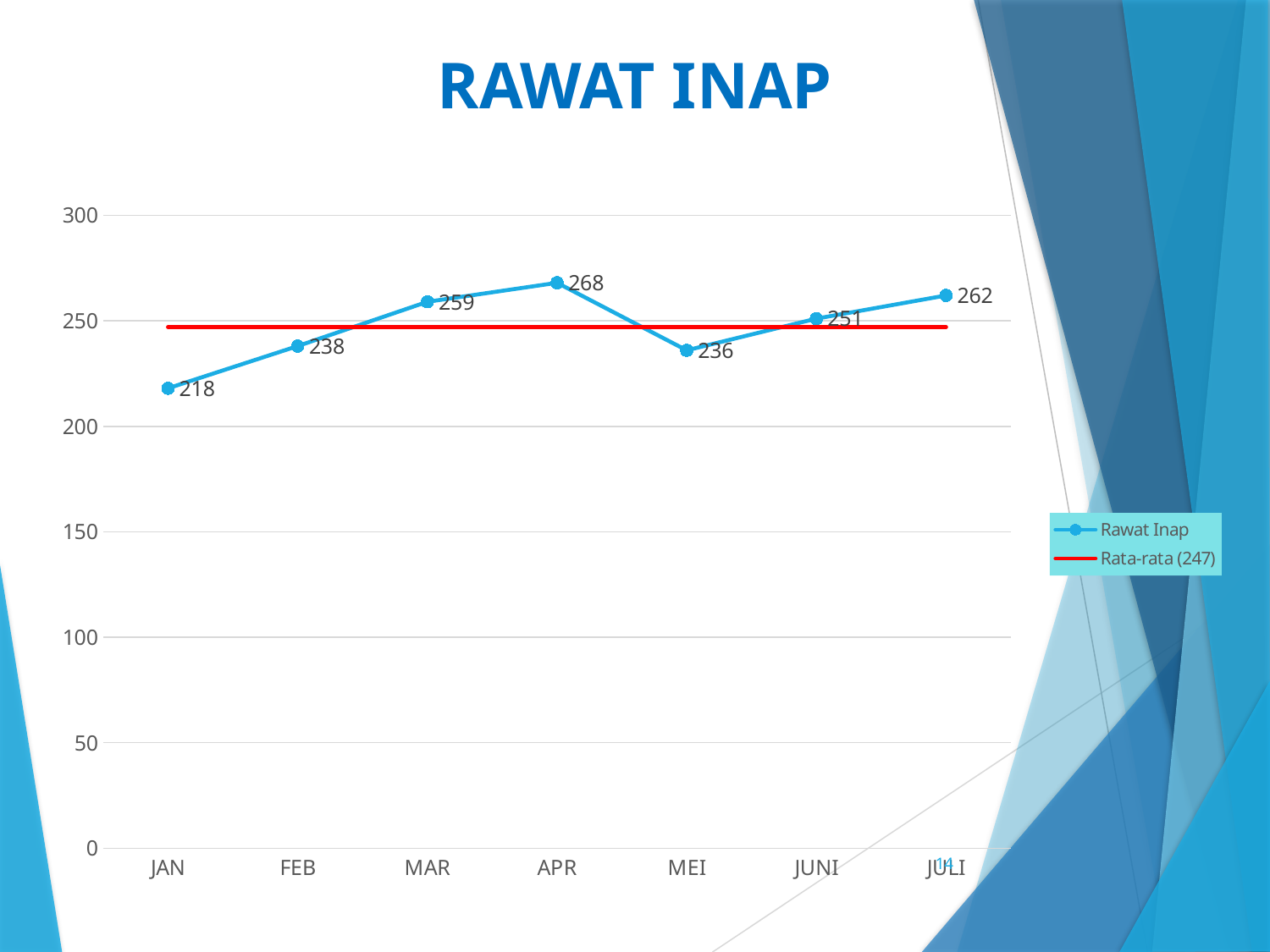
Which month has the highest Rawat Inap value? APR How many months are shown on the x axis? 7 What is the Rawat Inap value for JAN? 218 What is the Rawat Inap value for MEI? 236 Is the Rawat Inap value for FEB greater or less than 250? less How many series does the legend list? 2 What is the difference between the Rawat Inap values for APR and JAN? 50 Which is larger, the Rawat Inap value for MAR or for JULI? JULI What value does the legend give for the Rata-rata line? 247 What kind of chart is shown on the slide? line chart Which month has the lowest Rawat Inap value? JAN What is the Rawat Inap value for APR? 268